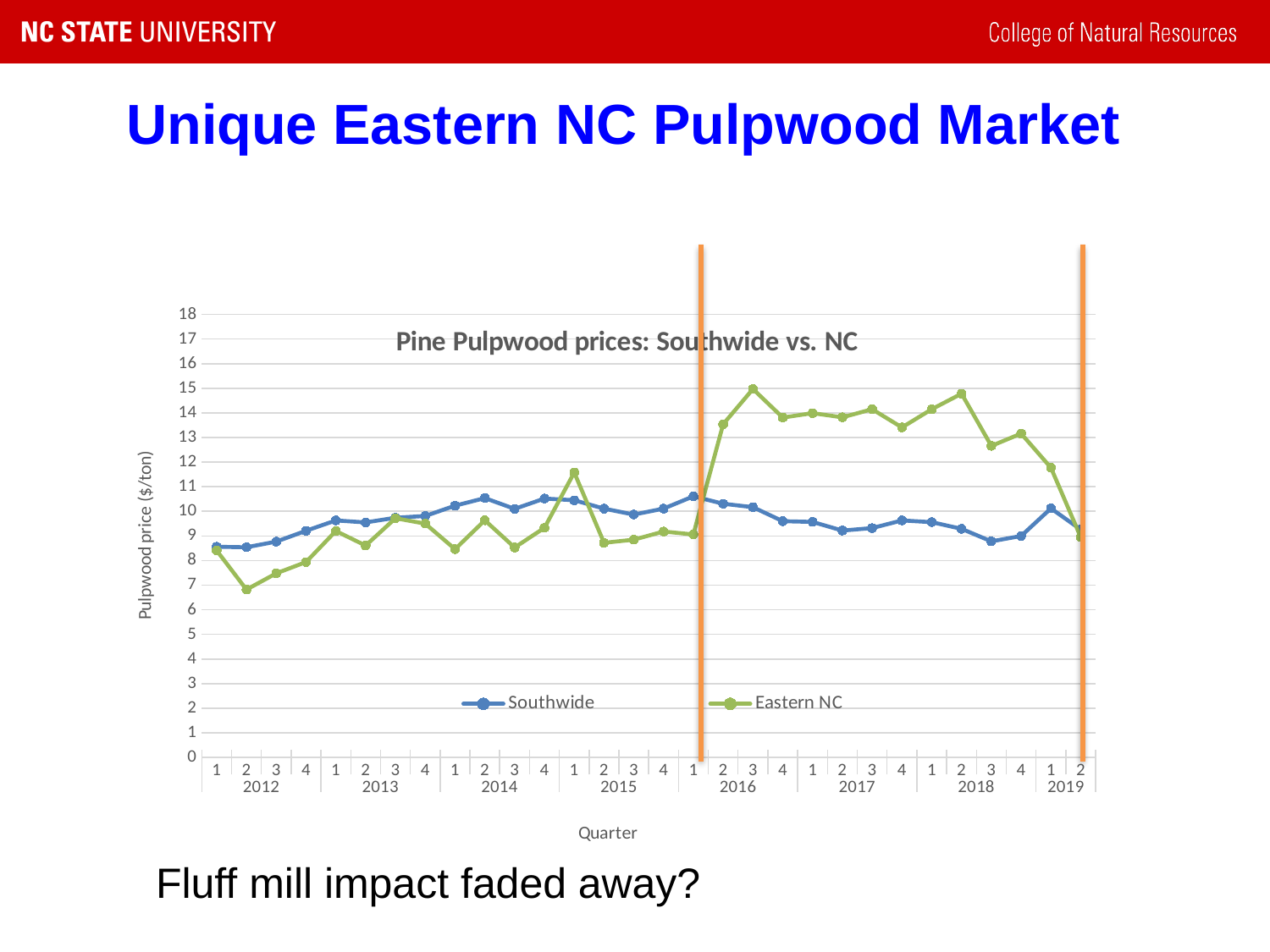
Is the Eastern NC value for quarter 3 of 2016 greater or less than 14? greater What is the label on the vertical axis of the chart? Pulpwood price ($/ton) What is the title of the chart? Pine Pulpwood prices: Southwide vs. NC Does the Eastern NC series rise or fall from quarter 2 of 2018 to quarter 2 of 2019? fall Is the Southwide value for quarter 1 of 2012 greater or less than 9? less Is the Eastern NC value for quarter 2 of 2012 greater or less than 8? less What kind of chart is shown on the slide? line chart In which quarter is the Eastern NC series at its lowest value? Quarter 2 of 2012 How many series does the chart's legend list? 2 In quarter 3 of 2016, which series has the higher value, Southwide or Eastern NC? Eastern NC How many quarterly data points are plotted for each series? 30